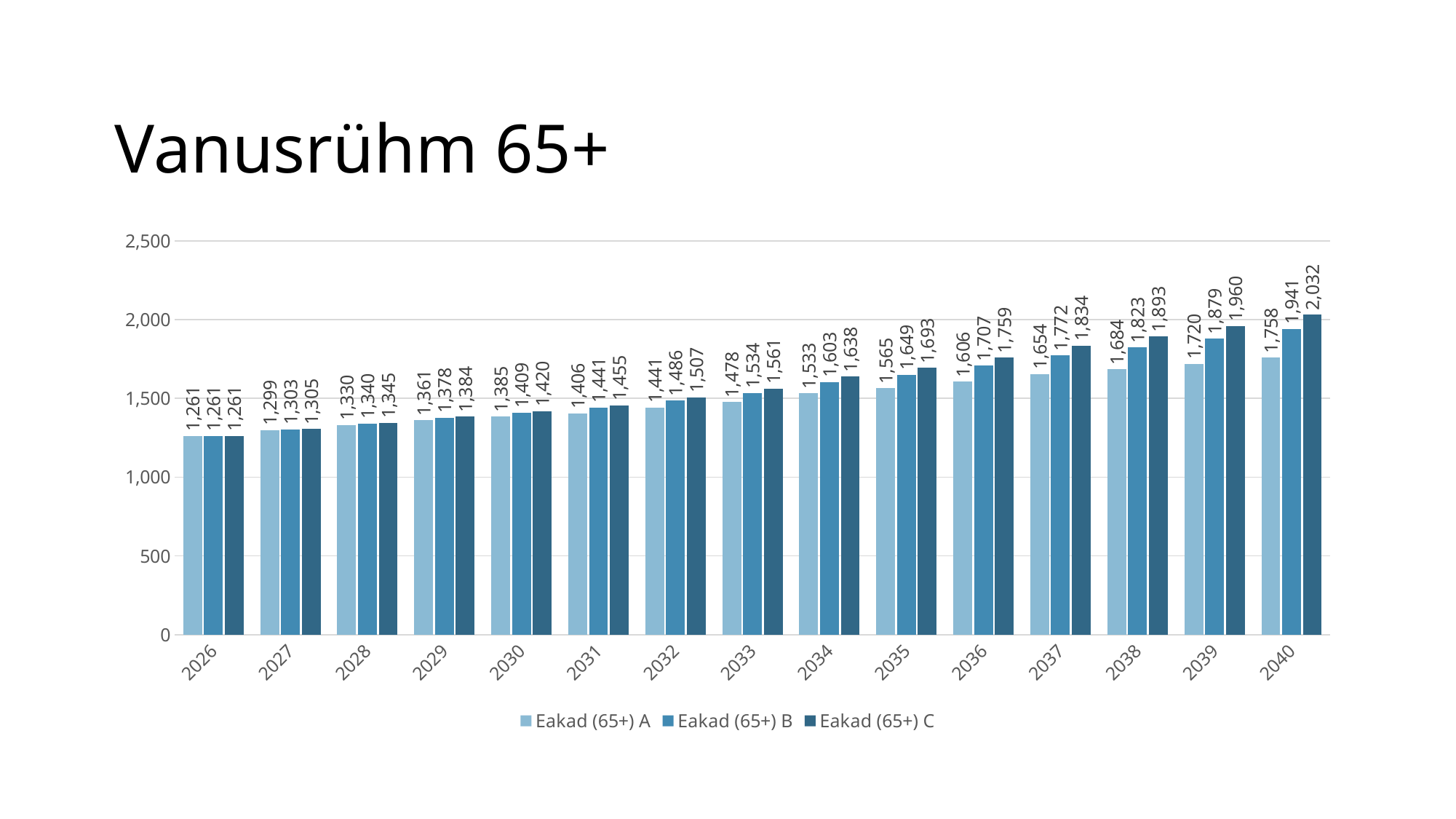
Which is larger in 2035: Eakad (65+) B or Eakad (65+) A? Eakad (65+) B What is the value for Eakad (65+) B in 2033? 1,534 How many series does the legend list? 3 How many years are shown on the x axis? 15 Do the values for Eakad (65+) B rise or fall from 2026 to 2040? Rise Is the value for Eakad (65+) C in 2040 greater or less than 2,000? greater What kind of chart is shown on the slide? Bar chart What is the value for Eakad (65+) A in 2026? 1,261 Which year has the lowest value for Eakad (65+) A? 2026 Which year has the highest value for Eakad (65+) C? 2040 What is the difference between Eakad (65+) C and Eakad (65+) A in 2040? 274 What is the value for Eakad (65+) C in 2040? 2,032